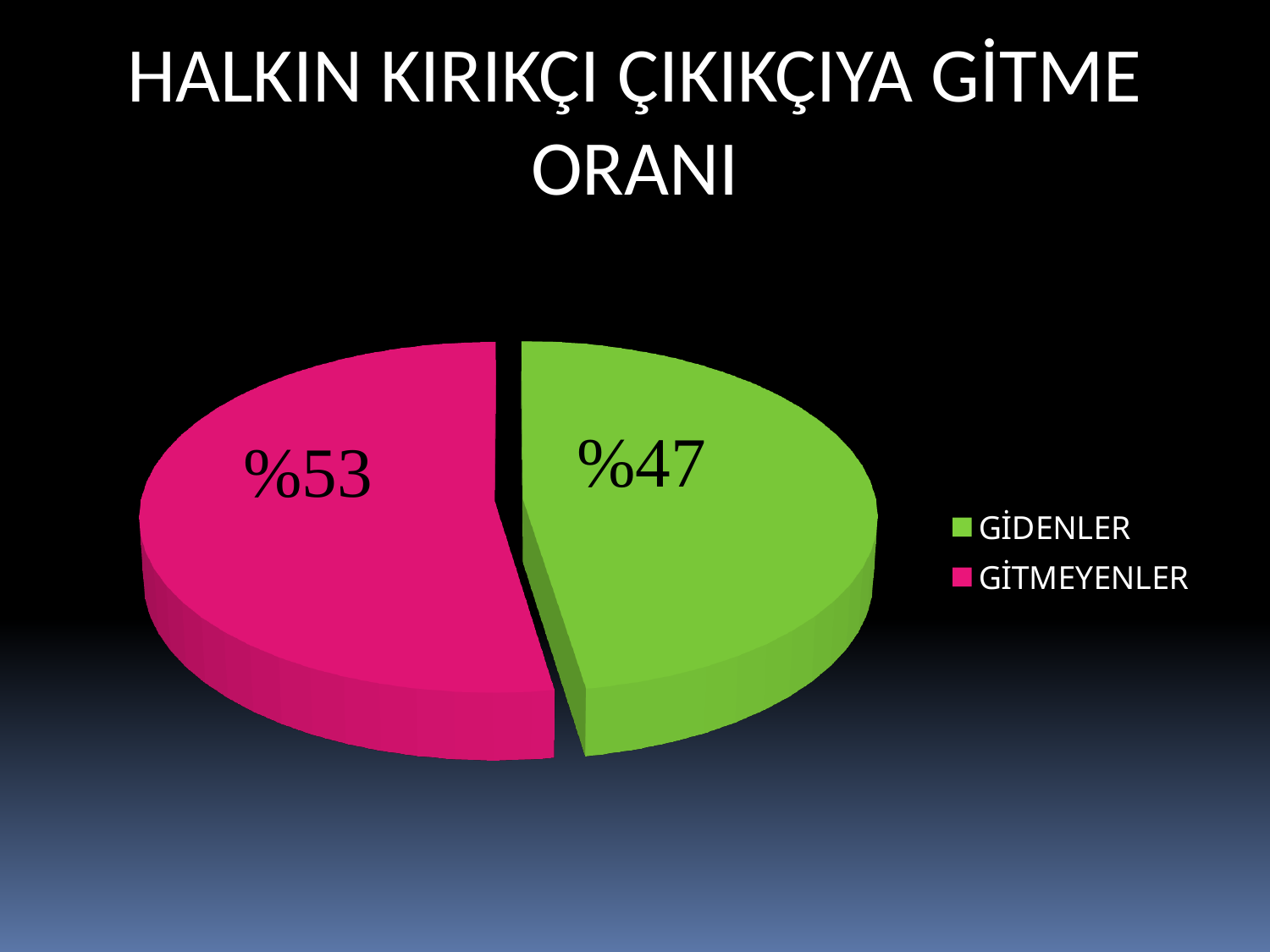
What share of the pie does GİDENLER represent? %47 How many slices does the pie chart have? 2 What is the value for GİTMEYENLER? %53 Which category has the largest slice? GİTMEYENLER What is the difference between the GİTMEYENLER and GİDENLER values? 6 percentage points Which category has the smallest slice? GİDENLER What is the title of the chart? HALKIN KIRIKÇI ÇIKIKÇIYA GİTME ORANI What kind of chart is shown on the slide? pie chart What is the value for GİDENLER? %47 Which is larger, GİDENLER or GİTMEYENLER? GİTMEYENLER How many entries does the legend list? 2 What colour is the GİTMEYENLER slice? pink